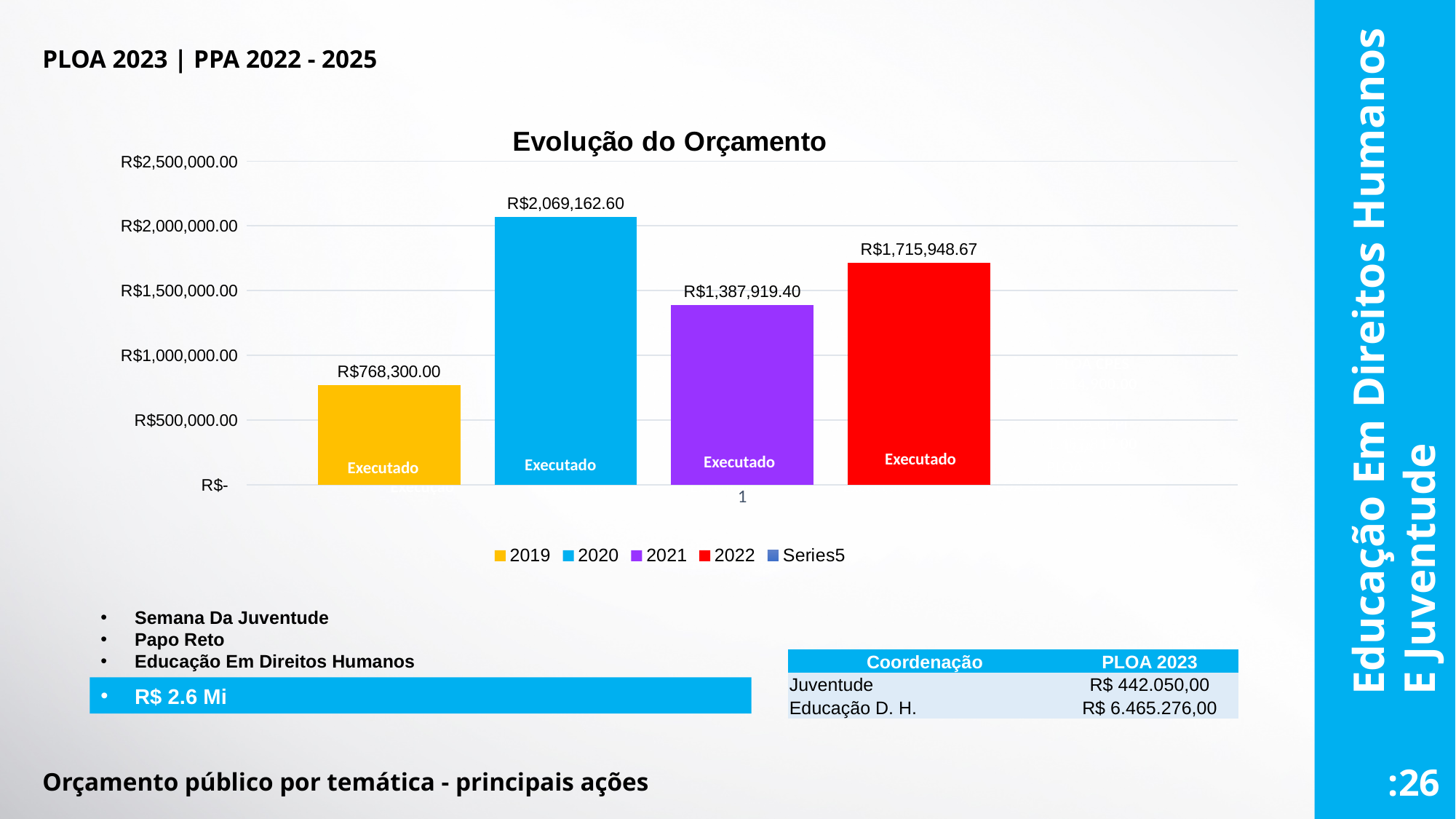
What is the value of the 2021 bar in the Evolução do Orçamento chart? R$1,387,919.40 What colour is the 2022 bar in the Evolução do Orçamento chart? Red What is the difference between the 2022 and 2021 values in the Evolução do Orçamento chart? R$328,029.27 What is the value of the 2020 bar in the Evolução do Orçamento chart? R$2,069,162.60 Which year has the highest value in the Evolução do Orçamento chart? 2020 Which year has the lowest value in the Evolução do Orçamento chart? 2019 How many series does the legend of the Evolução do Orçamento chart list? 5 Which is larger in the Evolução do Orçamento chart, the 2021 value or the 2022 value? 2022 What is the value of the 2022 bar in the Evolução do Orçamento chart? R$1,715,948.67 What kind of chart is Evolução do Orçamento? Bar chart What is the value of the 2019 bar in the Evolução do Orçamento chart? R$768,300.00 What is the difference between the 2020 and 2019 values in the Evolução do Orçamento chart? R$1,300,862.60